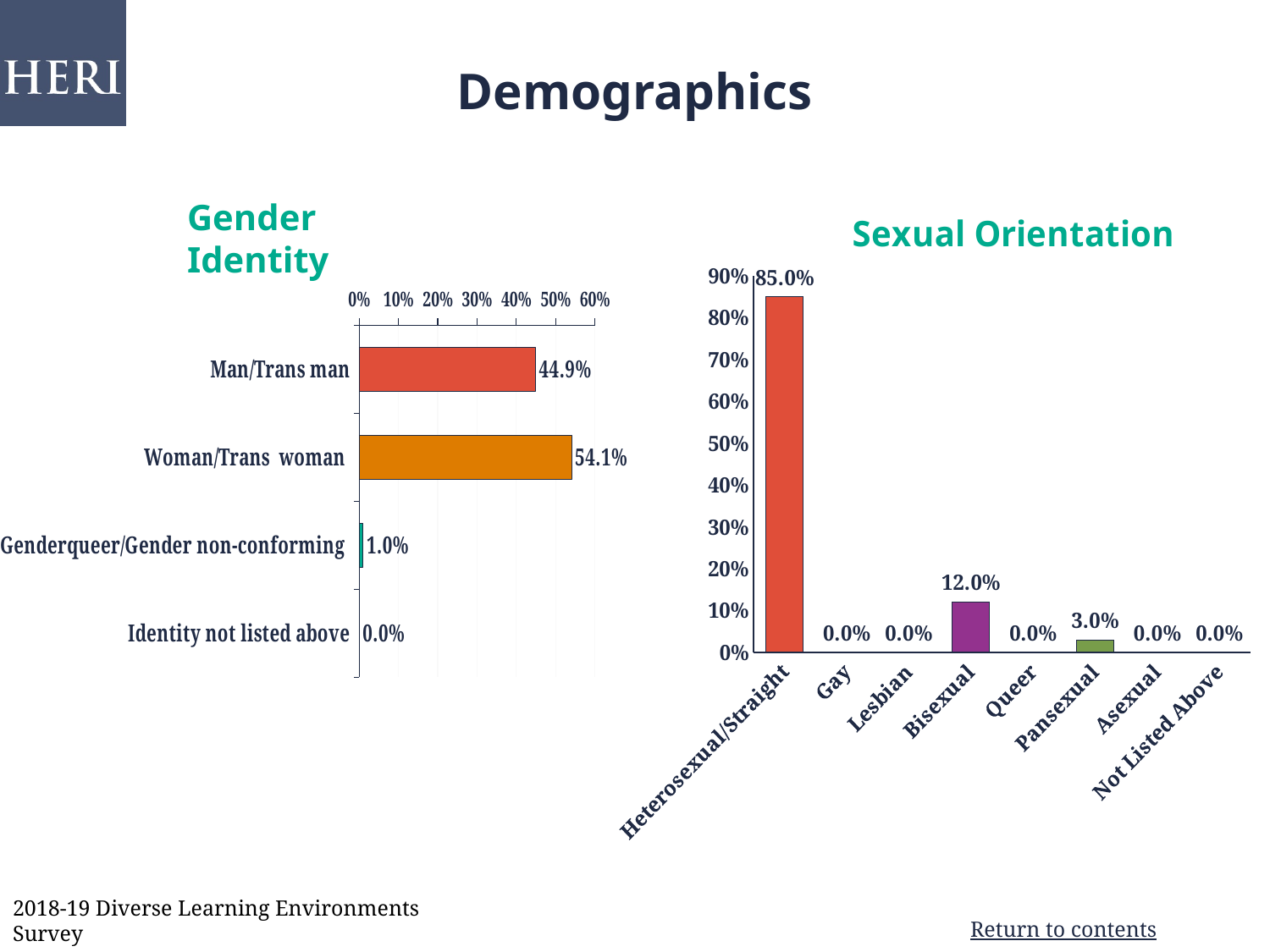
In the Gender Identity chart, how many categories are shown? 4 In the Sexual Orientation chart, what is the value for Bisexual? 12.0% In the Gender Identity chart, what is the difference between Woman/Trans woman and Man/Trans man? 9.2% In the Sexual Orientation chart, which category has the highest value? Heterosexual/Straight In the Gender Identity chart, what is the value for Genderqueer/Gender non-conforming? 1.0% In the Gender Identity chart, what is the value for Man/Trans man? 44.9% In the Sexual Orientation chart, what is the value for Pansexual? 3.0% In the Gender Identity chart, which category has the highest value? Woman/Trans woman In the Gender Identity chart, what is the value for Woman/Trans woman? 54.1% What type of chart is the Sexual Orientation chart? Bar chart In the Sexual Orientation chart, how many categories are shown on the x axis? 8 In the Sexual Orientation chart, what is the value for Heterosexual/Straight? 85.0%